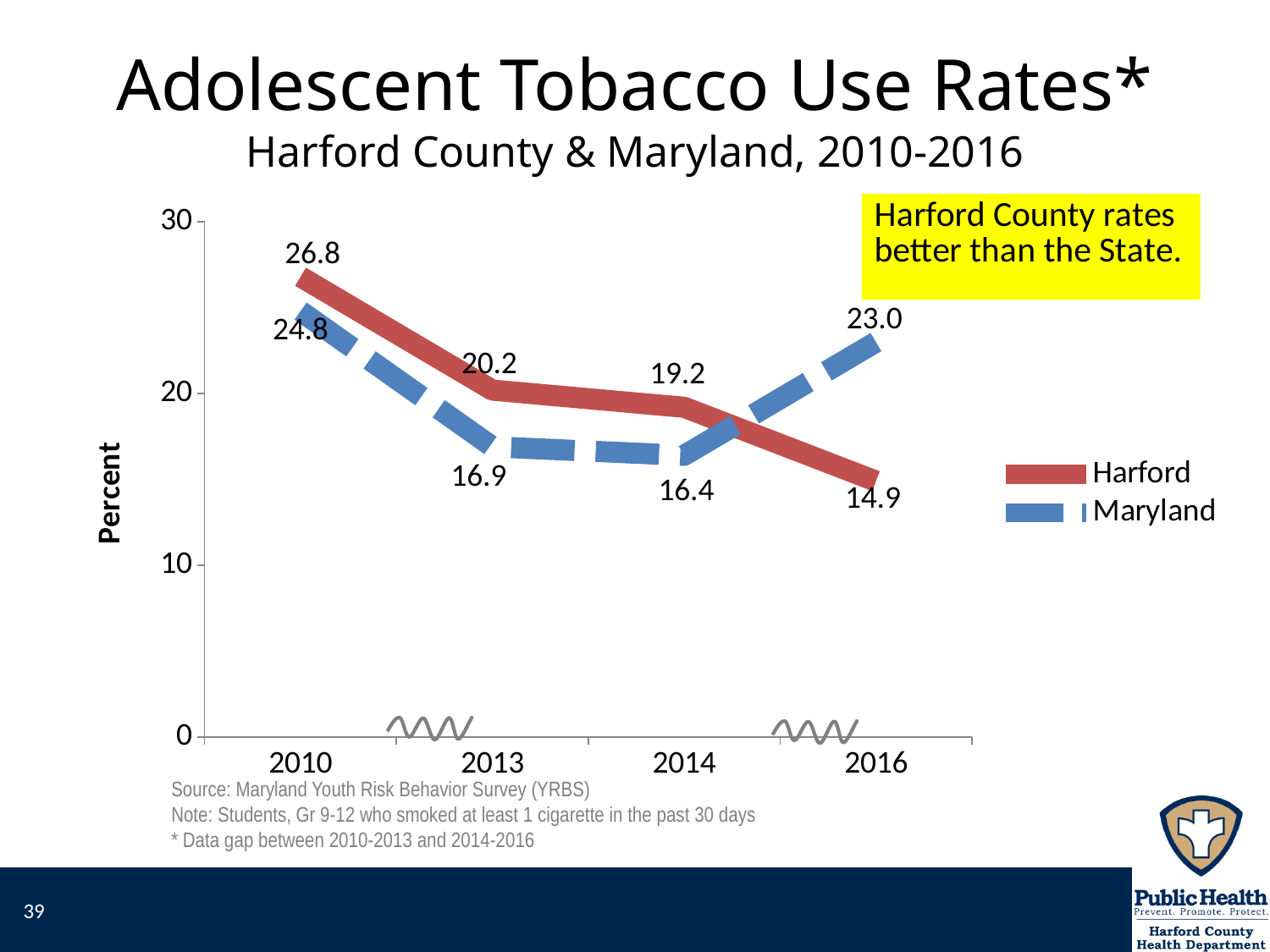
How many years are plotted on the x axis? 4 Does the Harford rate rise or fall from 2010 to 2016? Fall What is the label on the y axis? Percent What was the Maryland rate in 2014? 16.4 Which series had the higher rate in 2013, Harford or Maryland? Harford In which year was the Harford rate lowest? 2016 How many series does the legend list? 2 In which year was the Maryland rate highest? 2010 What is the difference between the Harford and Maryland rates in 2016? 8.1 What kind of chart is shown on the slide? Line chart What was the Maryland adolescent tobacco use rate in 2016? 23.0 What was the Harford adolescent tobacco use rate in 2010? 26.8